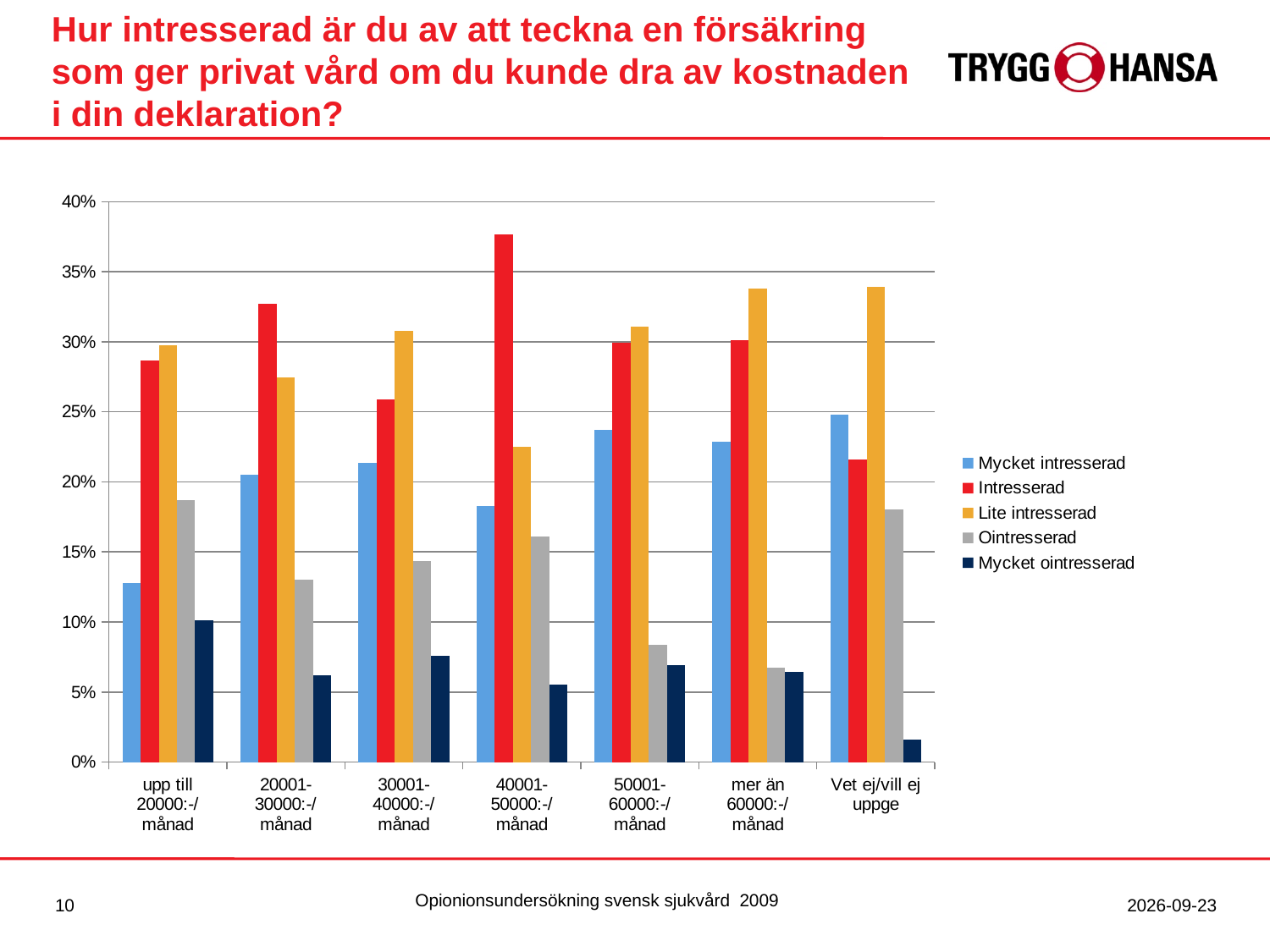
In which category is the Mycket ointresserad bar lowest? Vet ej/vill ej uppge In which category is the Mycket ointresserad bar highest? upp till 20000:-/månad For Vet ej/vill ej uppge, which is larger: Mycket intresserad or Intresserad? Mycket intresserad Is the Intresserad value for 40001-50000:-/månad greater or less than 35%? greater What colour represents the Intresserad series in the legend? red What kind of chart is shown on the slide? bar chart How many series does the legend list? 5 In which category is the Intresserad bar highest? 40001-50000:-/månad For 20001-30000:-/månad, which is larger: Intresserad or Lite intresserad? Intresserad Is the Mycket ointresserad value for Vet ej/vill ej uppge greater or less than 5%? less How many income categories are shown on the x axis? 7 Is the Mycket intresserad value for upp till 20000:-/månad greater or less than 15%? less